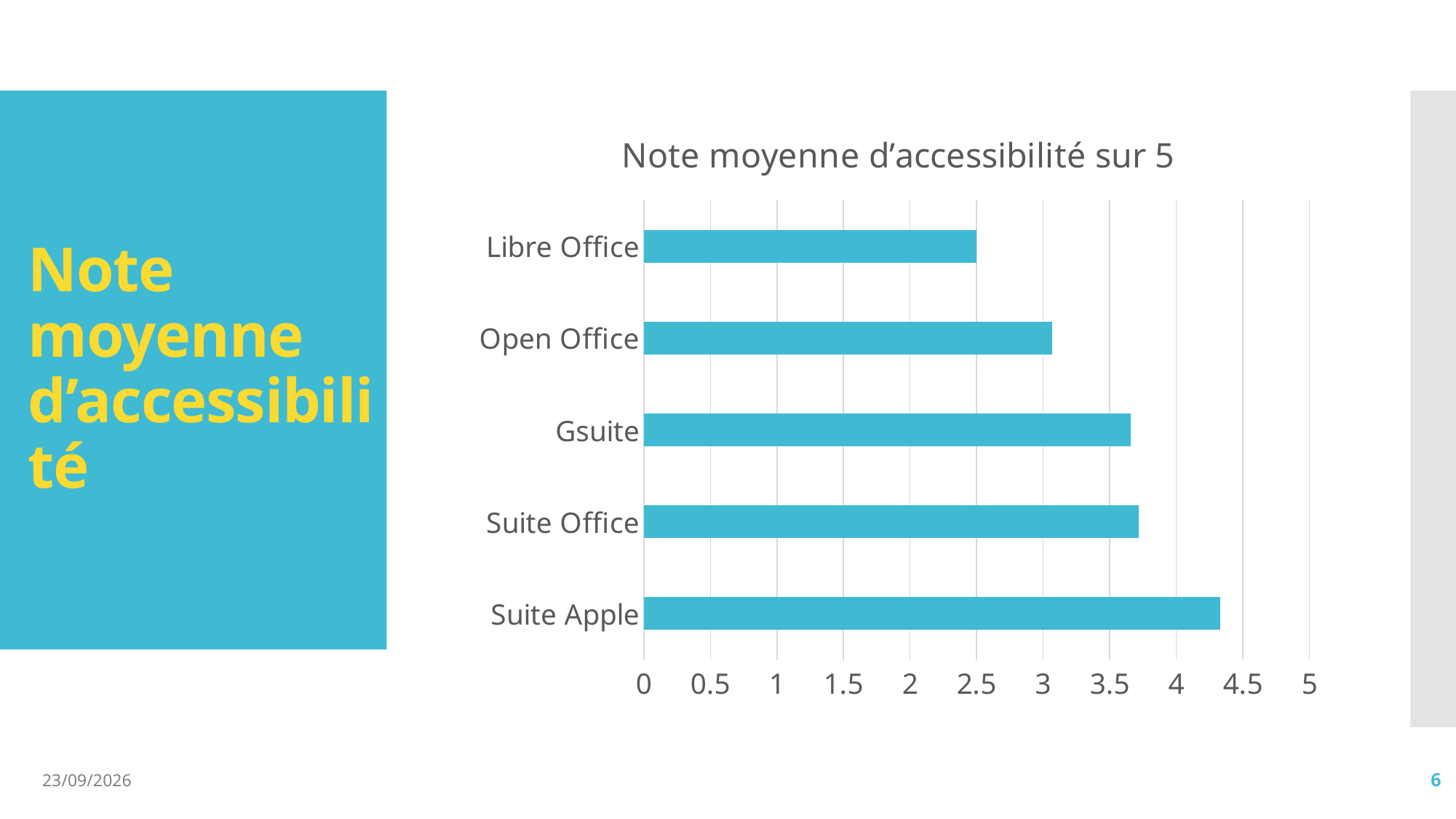
Is the value for Gsuite greater or less than 3.5? greater Is the value for Suite Office greater or less than 4? less Which office suite has the lowest average accessibility score? Libre Office Which has a higher average accessibility score, Open Office or Gsuite? Gsuite Which has a higher average accessibility score, Libre Office or Suite Apple? Suite Apple How many office suites are compared in the chart? 5 Is the value for Suite Apple greater or less than 4? greater Which office suite has the highest average accessibility score? Suite Apple What is the average accessibility score for Libre Office? 2.5 What kind of chart is shown on the slide? Bar chart What is the maximum value shown on the horizontal axis of the chart? 5